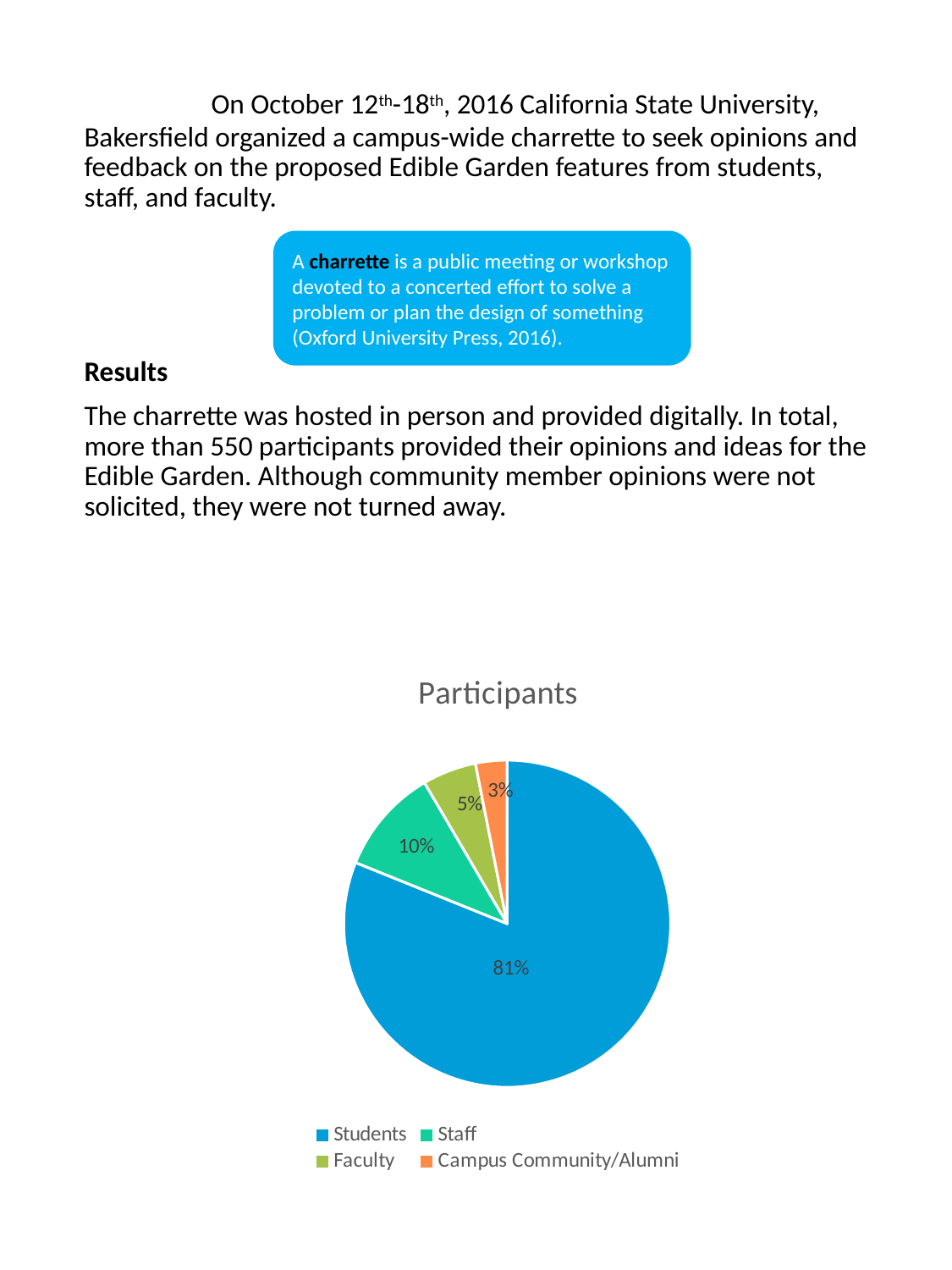
Which participant group has the largest share of the pie? Students Which group has a larger share, Staff or Faculty? Staff What share of participants were Students? 81% What share of participants were Campus Community/Alumni? 3% Which colour represents Campus Community/Alumni in the pie chart? Orange What is the title of the chart? Participants What share of participants were Staff? 10% How many categories does the pie chart show? 4 What kind of chart is shown on the slide? Pie chart Which participant group has the smallest share of the pie? Campus Community/Alumni What is the difference in percentage points between the Students share and the Staff share? 71